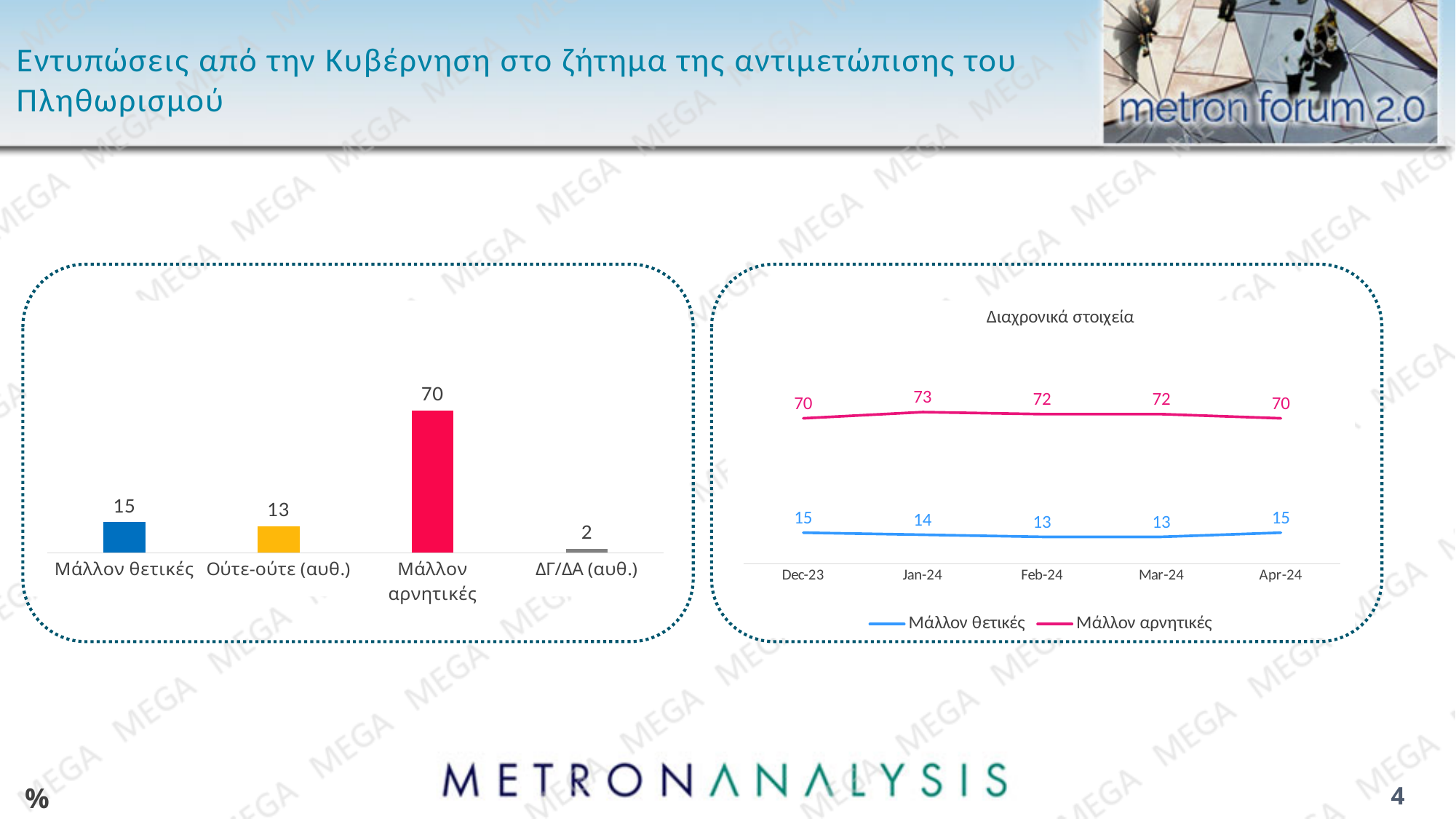
In the bar chart on the left, what is the value for Μάλλον αρνητικές? 70 In the bar chart on the left, which category has the lowest value? ΔΓ/ΔΑ (αυθ.) In the Διαχρονικά στοιχεία chart, what is the difference between Μάλλον αρνητικές and Μάλλον θετικές in Apr-24? 55 In the Διαχρονικά στοιχεία chart, what is the value for Μάλλον αρνητικές in Jan-24? 73 In the Διαχρονικά στοιχεία chart, which is larger in Mar-24: Μάλλον θετικές or Μάλλον αρνητικές? Μάλλον αρνητικές In the bar chart on the left, what is the difference between Μάλλον θετικές and Ούτε-ούτε (αυθ.)? 2 In the bar chart on the left, which category has the highest value? Μάλλον αρνητικές What kind of chart is the Διαχρονικά στοιχεία chart on the right? line chart What kind of chart is the chart on the left? bar chart In the bar chart on the left, how many categories are shown? 4 In the Διαχρονικά στοιχεία chart, what is the value for Μάλλον θετικές in Feb-24? 13 In the Διαχρονικά στοιχεία chart, how many series does the legend list? 2